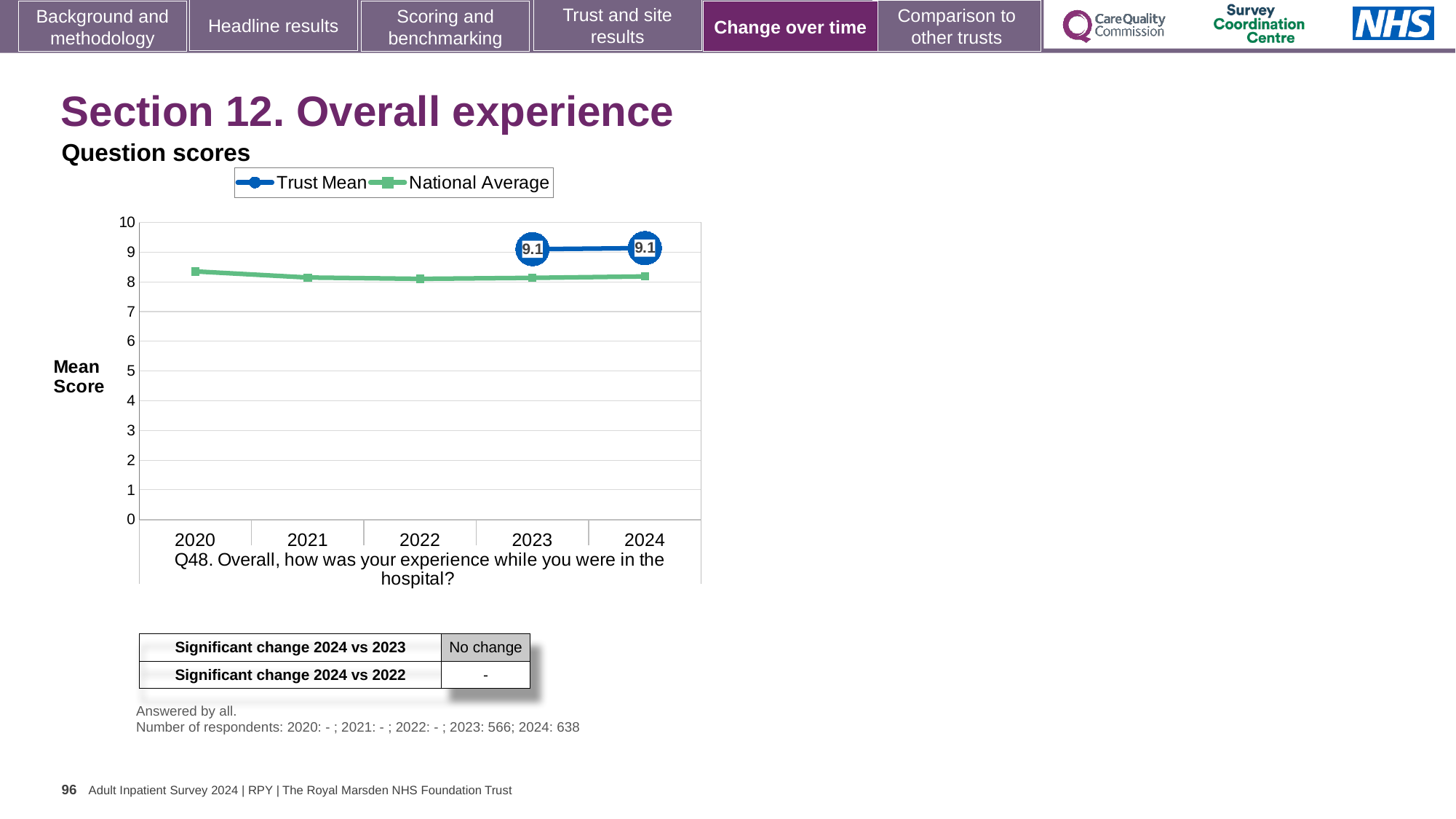
Is the National Average value for 2020 greater or less than 8? greater How many series does the chart legend list? 2 What is the Trust Mean value for 2024? 9.1 What is the difference between the Trust Mean in 2024 and the Trust Mean in 2023? 0 In 2023, which is larger: the Trust Mean or the National Average? Trust Mean Is the Trust Mean value for 2024 greater or less than 9? greater How many years are shown on the x axis of the chart? 5 What is the Trust Mean value for 2023? 9.1 Does the Trust Mean rise, fall or stay the same from 2023 to 2024? stays the same Is the National Average value for 2024 greater or less than 9? less What is the label on the y axis of the chart? Mean Score What kind of chart is shown on the slide? line chart